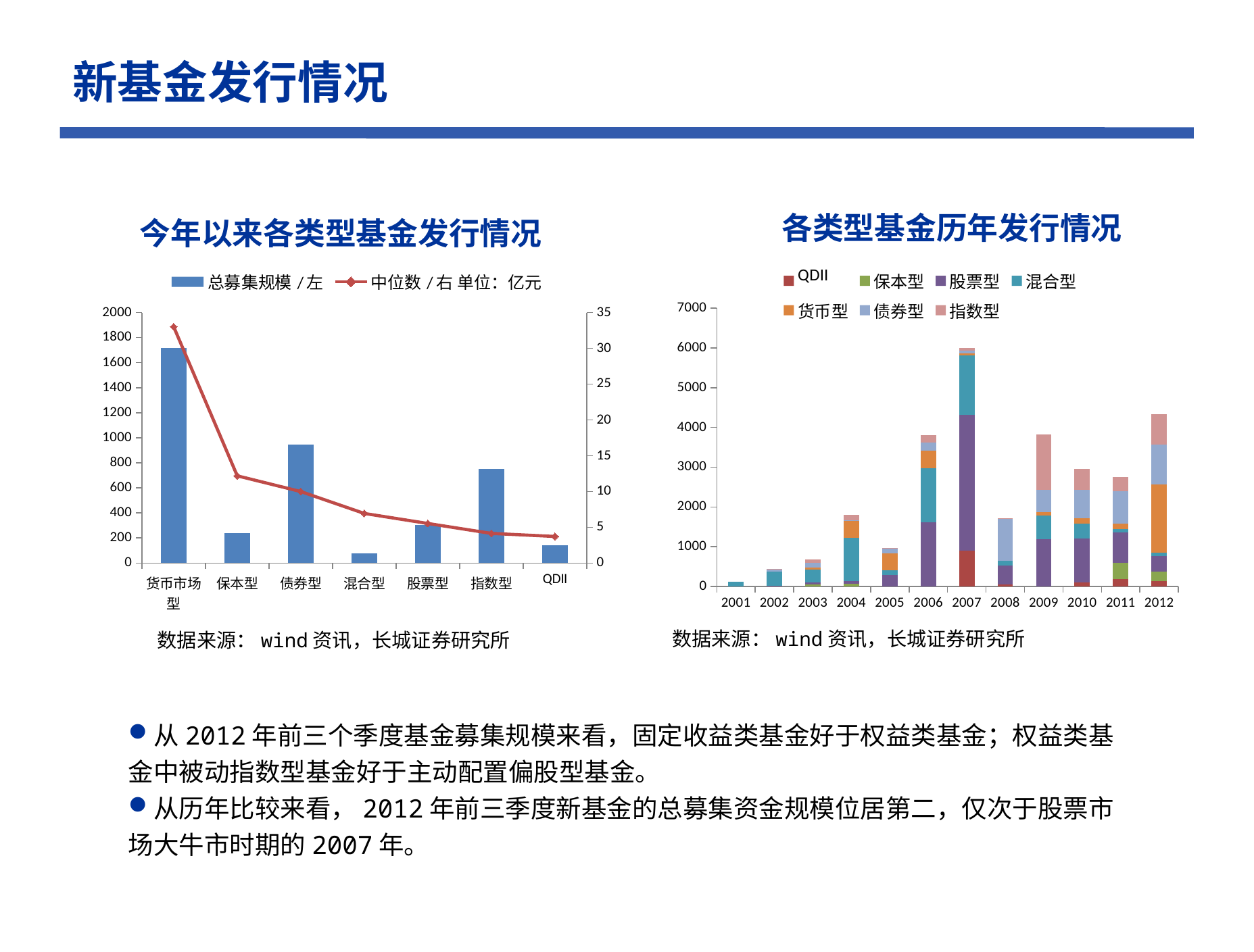
On the left chart (今年以来各类型基金发行情况), which category has the lowest 总募集规模 bar? 混合型 On the left chart (今年以来各类型基金发行情况), which has the larger 总募集规模 bar, 债券型 or 指数型? 债券型 On the left chart (今年以来各类型基金发行情况), is the 总募集规模 value for 债券型 greater or less than 800? greater On the left chart (今年以来各类型基金发行情况), how many categories are shown on the x axis? 7 On the right chart (各类型基金历年发行情况), which year has the shortest stacked bar? 2001 On the right chart (各类型基金历年发行情况), how many series does the legend list? 7 On the right chart (各类型基金历年发行情况), is the total for 2007 greater or less than 5000? greater What kind of chart is the right chart (各类型基金历年发行情况)? stacked bar chart On the left chart (今年以来各类型基金发行情况), does the 中位数 line rise or fall from 货币市场型 to QDII? fall On the left chart (今年以来各类型基金发行情况), is the 总募集规模 value for 货币市场型 greater or less than 1600? greater On the left chart (今年以来各类型基金发行情况), which category has the highest 总募集规模 bar? 货币市场型 On the right chart (各类型基金历年发行情况), which year has the tallest stacked bar? 2007